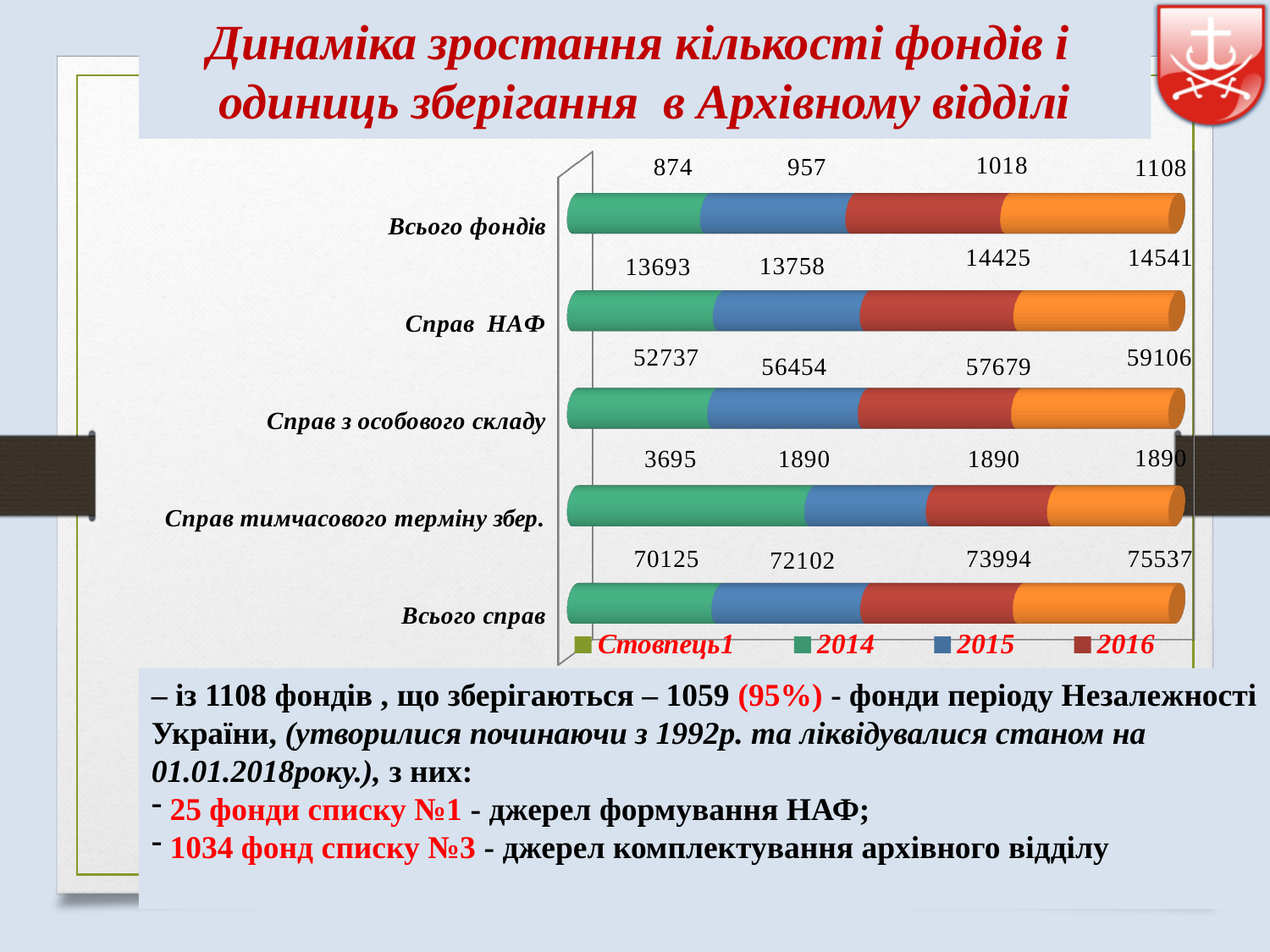
What is the 2015 value for "Всього справ"? 72102 What is the difference between the 2016 and 2015 values for "Всього справ"? 1892 What is the 2016 value for "Справ НАФ"? 14425 What is the 2014 value for "Всього фондів"? 874 What is the rightmost (last) data label on the "Справ з особового складу" bar? 59106 Which is larger in 2015: "Справ з особового складу" or "Справ НАФ"? Справ з особового складу What is the 2014 value for "Справ тимчасового терміну збер."? 3695 How many categories are plotted on the chart? 5 How many series does the chart legend list? 4 Do the data labels for "Всього справ" rise or fall from left to right along the bar? rise What kind of chart is shown on the slide? bar chart By how much did "Всього фондів" increase from 2014 to 2016? 144